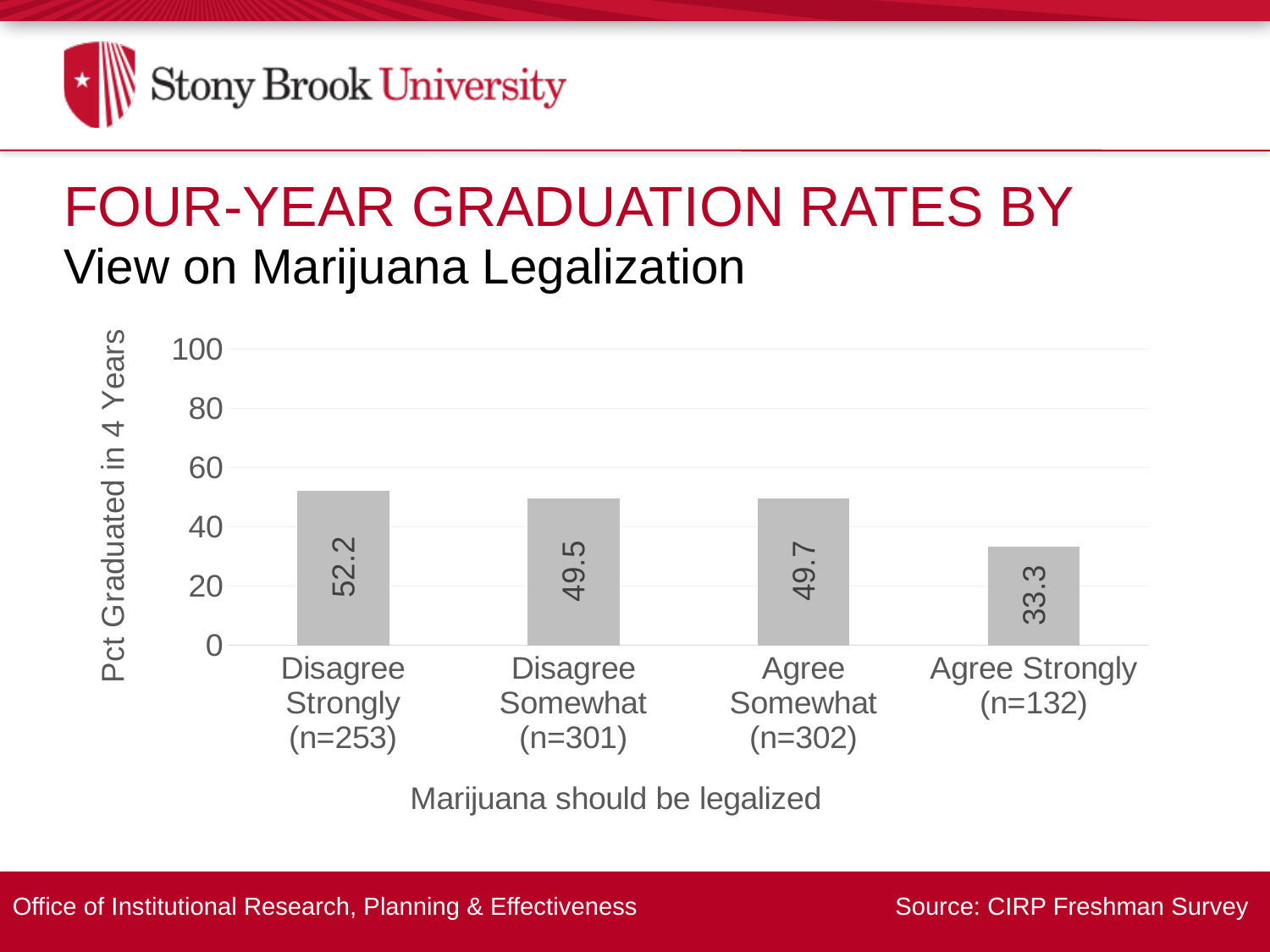
What is the value shown for the Disagree Somewhat bar? 49.5 Which category has the lowest four-year graduation rate? Agree Strongly Which is larger, the graduation rate for Disagree Strongly or for Agree Somewhat? Disagree Strongly What is the four-year graduation rate for the Agree Strongly group? 33.3 Is the value for Agree Strongly greater or less than 40? less How many categories are shown on the x axis? 4 What is the difference between the Agree Somewhat and Disagree Somewhat graduation rates? 0.2 What is the difference between the graduation rates for Disagree Strongly and Agree Strongly? 18.9 Which category has the highest four-year graduation rate? Disagree Strongly What kind of chart is shown on the slide? bar chart What is the sample size (n) for the Agree Somewhat group? 302 What is the four-year graduation rate for students who Disagree Strongly that marijuana should be legalized? 52.2